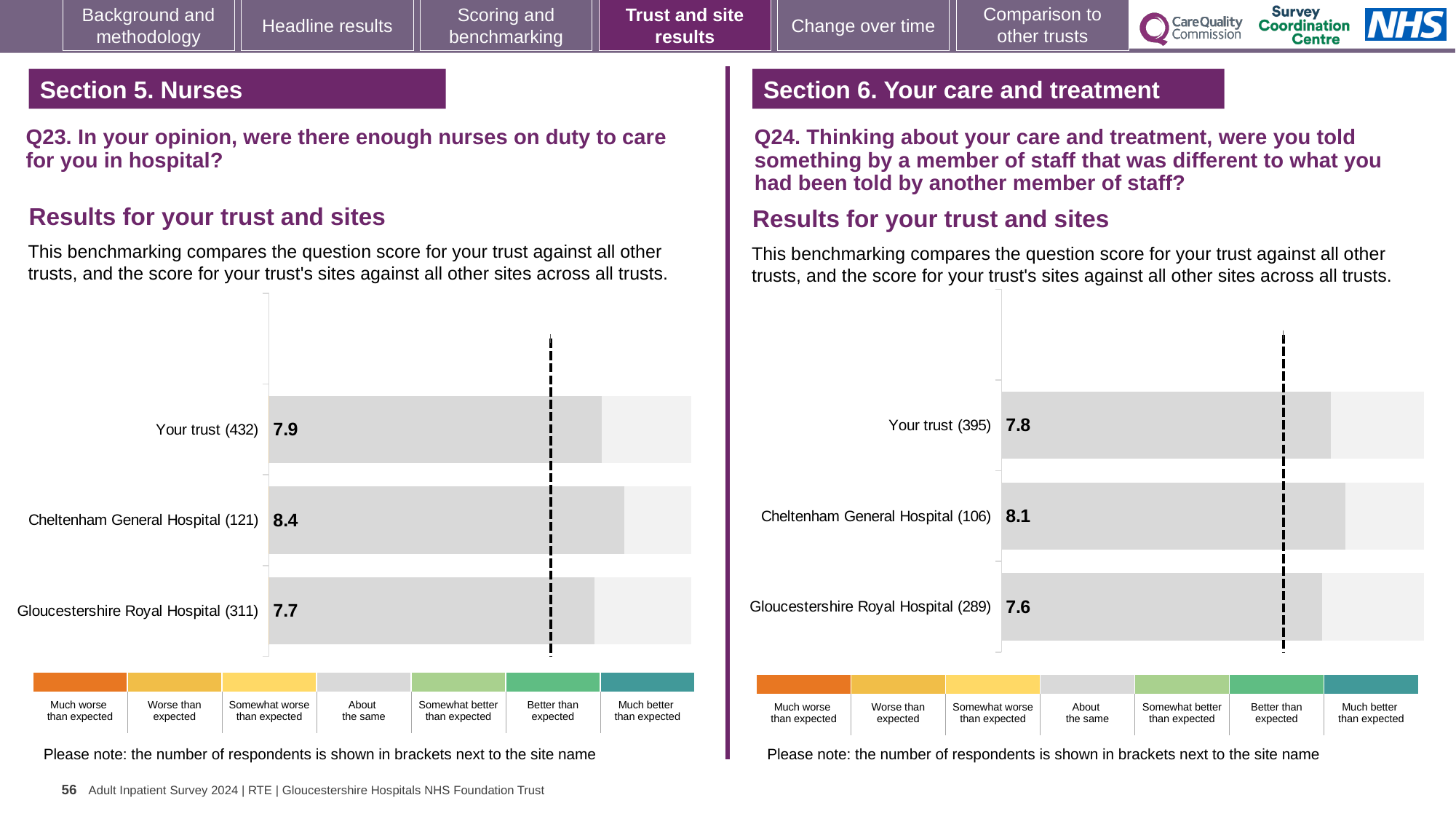
On the Q23 chart (left), how many respondents are shown for Your trust? 432 How many bars are plotted on the Q24 chart (right)? 3 On the Q23 chart (left), which site or trust has the lowest score? Gloucestershire Royal Hospital On the Q24 chart (right), what is the difference between the scores for Cheltenham General Hospital and Your trust? 0.3 On the Q23 chart (left), what is the difference between the scores for Cheltenham General Hospital and Gloucestershire Royal Hospital? 0.7 What kind of chart is the Q23 chart (left)? Bar chart On the Q23 chart (left), what is the score for Your trust? 7.9 On the Q24 chart (right), what is the score for Cheltenham General Hospital? 8.1 On the Q24 chart (right), which is larger, the score for Your trust or the score for Gloucestershire Royal Hospital? Your trust On the Q23 chart (left), what is the score for Cheltenham General Hospital? 8.4 On the Q23 chart (left), which site or trust has the highest score? Cheltenham General Hospital On the Q24 chart (right), what is the score for Gloucestershire Royal Hospital? 7.6